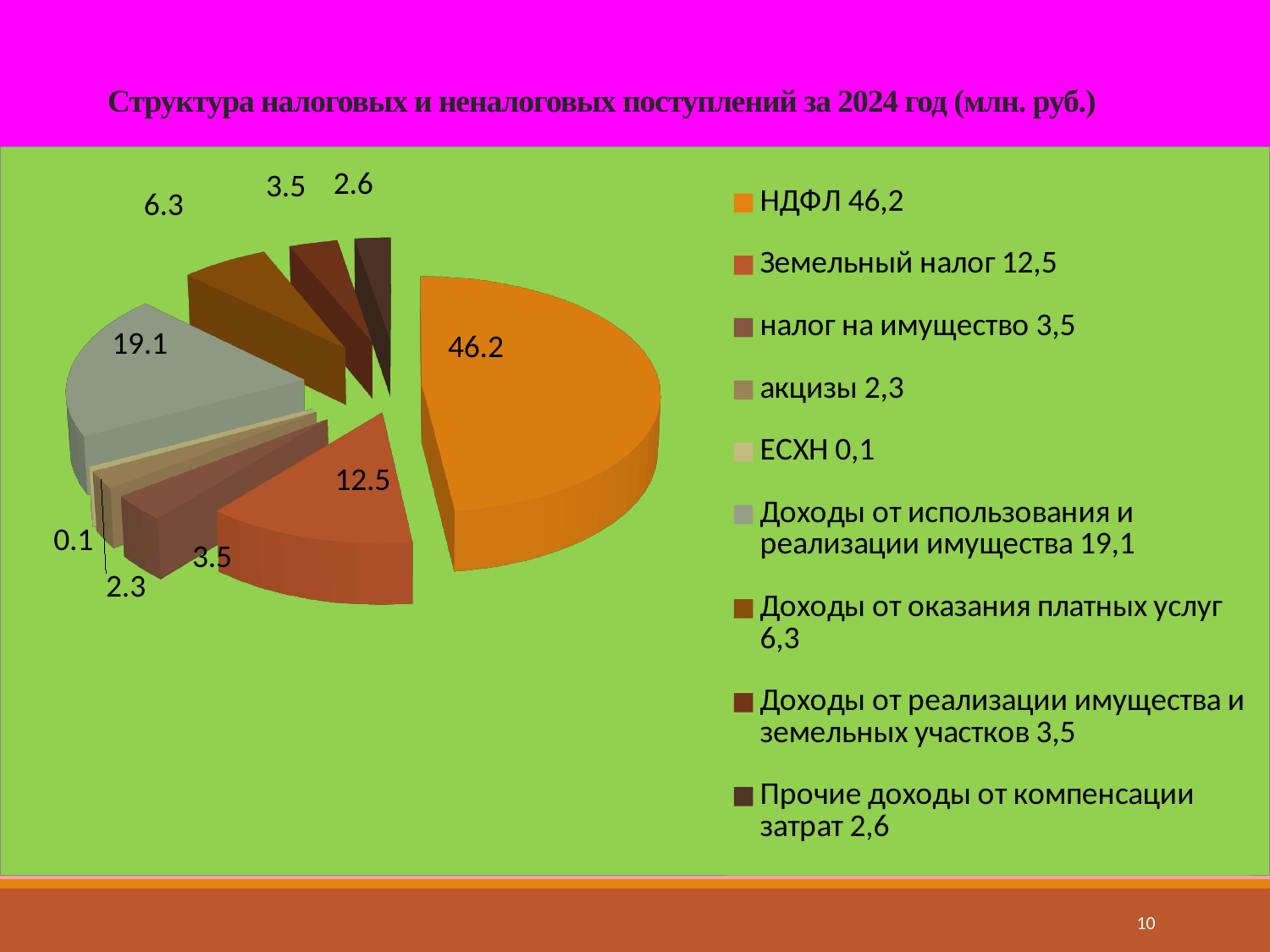
What is the value shown for ЕСХН? 0.1 Which category has the largest slice of the pie? НДФЛ What is the title of the chart? Структура налоговых и неналоговых поступлений за 2024 год (млн. руб.) What is the difference between the values for НДФЛ and Земельный налог? 33.7 What kind of chart is shown on the slide? Pie chart What is the value shown for Доходы от использования и реализации имущества? 19.1 Which category has the smallest slice of the pie? ЕСХН What is the value shown for НДФЛ? 46.2 What is the value shown for Доходы от оказания платных услуг? 6.3 How many categories does the pie chart have? 9 What is the value shown for Земельный налог? 12.5 Which is larger: Земельный налог or Доходы от использования и реализации имущества? Доходы от использования и реализации имущества